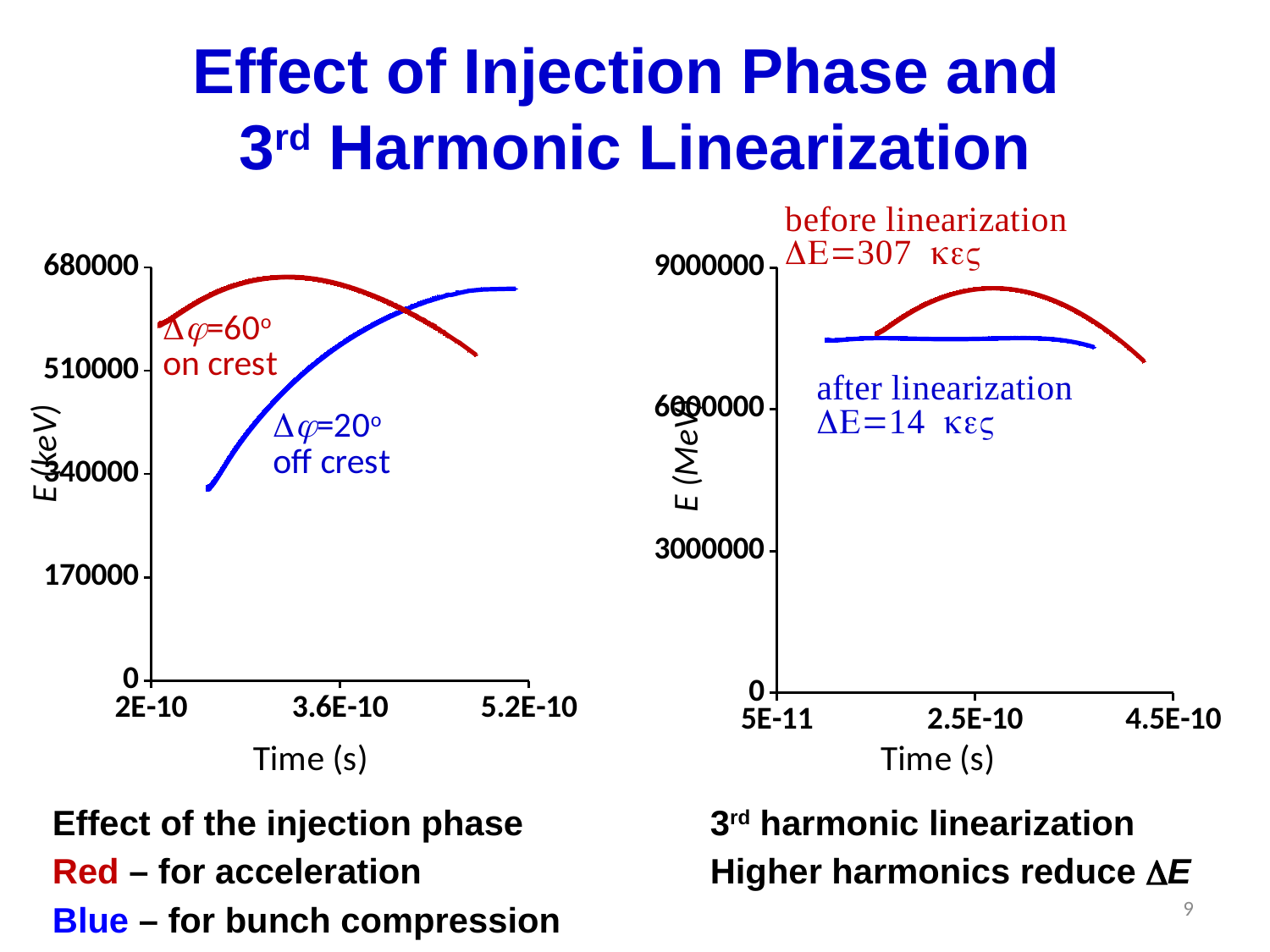
On the left chart, is the peak of the red Δφ=60° on crest curve greater or less than 510000? greater On the right chart, which curve reaches the higher maximum energy, 'before linearization' or 'after linearization'? before linearization What is the y-axis label of the left chart? E (keV) What kind of chart is the right chart (E (MeV) vs Time (s))? line chart On the right chart, is the blue 'after linearization' curve greater or less than 6000000? greater On the left chart, is the starting value of the blue Δφ=20° off crest curve greater or less than 340000? less On the left chart, does the blue Δφ=20° off crest curve rise or fall as time increases? rises How many curves are plotted on the left chart (E (keV) vs Time (s))? 2 How many curves are plotted on the right chart (E (MeV) vs Time (s))? 2 On the right chart, what ΔE value is annotated for the 'before linearization' curve? 307 What kind of chart is the left chart (E (keV) vs Time (s))? line chart